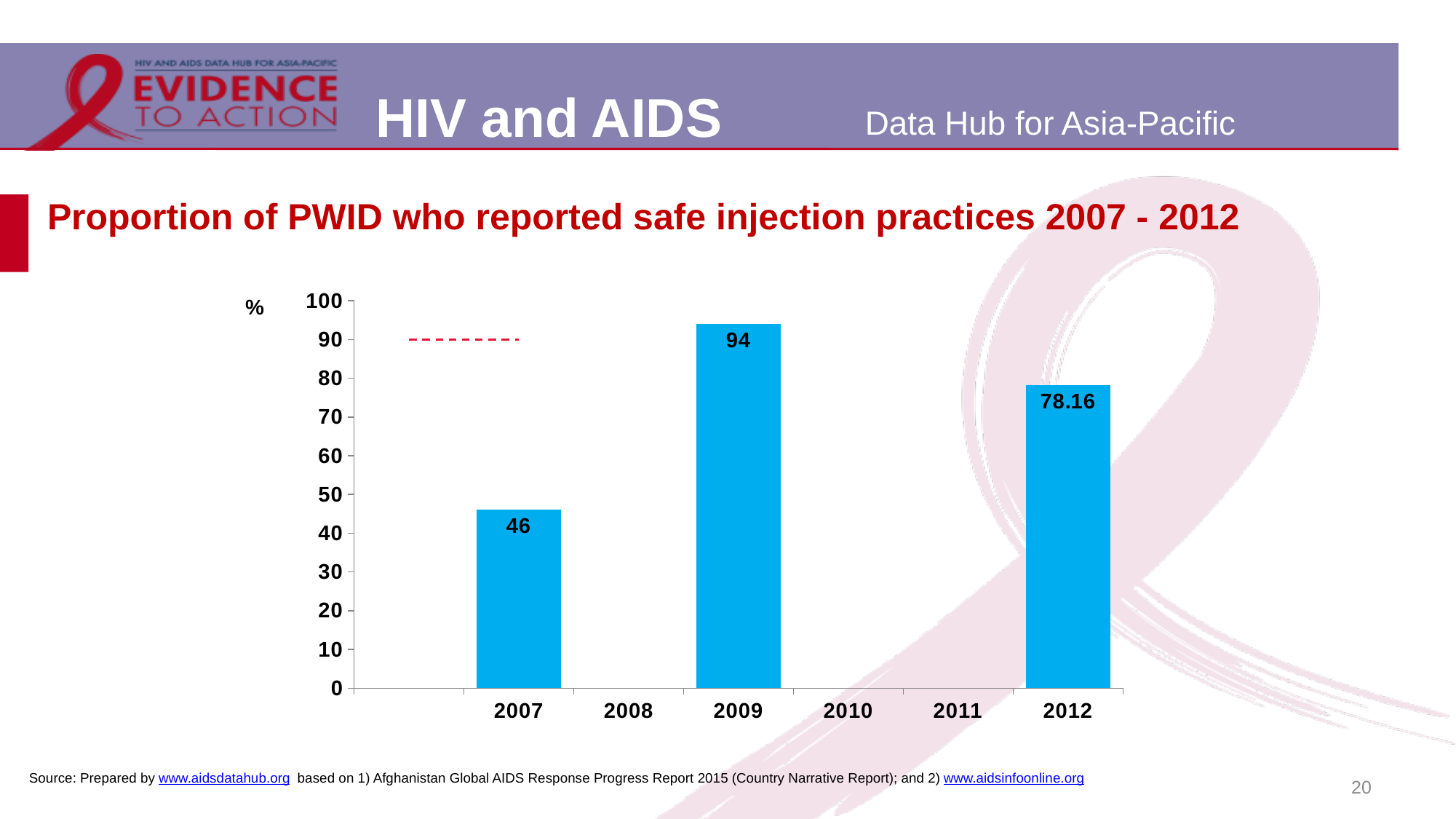
Is the value for 2012 greater or less than 70? greater How many years are labelled on the x axis? 6 Which year has the highest value? 2009 Which is larger, the value for 2012 or the value for 2007? 2012 What is the value for 2012? 78.16 Which year with a plotted bar has the lowest value? 2007 What is the value for 2009? 94 What is the title of the chart? Proportion of PWID who reported safe injection practices 2007 - 2012 What kind of chart is shown on the slide? Bar chart What is the difference between the values for 2009 and 2012? 15.84 What is the value for 2007? 46 What is the difference between the values for 2009 and 2007? 48